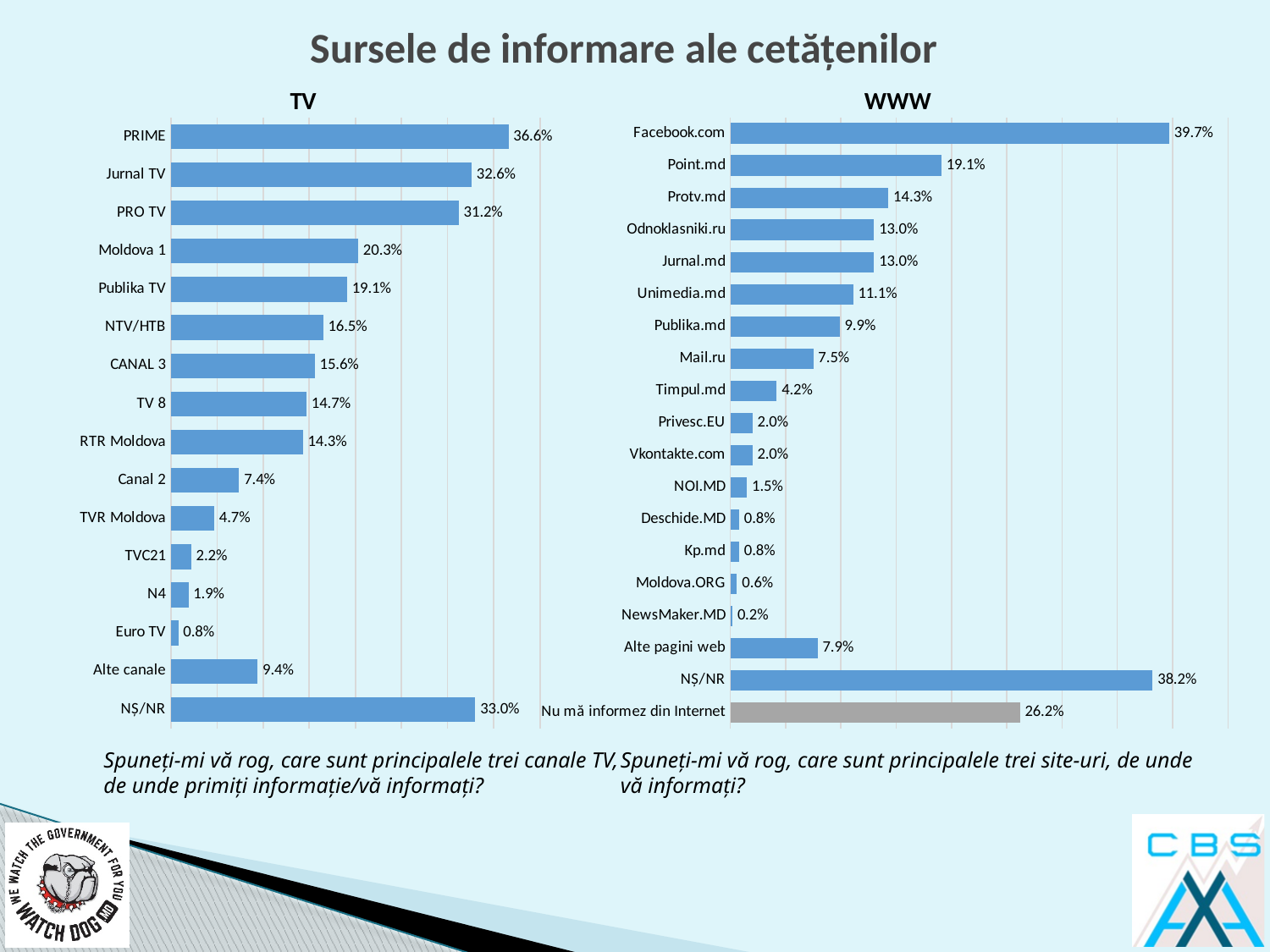
In the WWW chart, what is the value for Nu mă informez din Internet? 26.2% In the TV chart, what is the value for PRIME? 36.6% In the TV chart, what is the value for Moldova 1? 20.3% In the TV chart, what is the difference between Jurnal TV and PRO TV? 1.4% How many categories are shown in the TV chart? 16 How many categories are shown in the WWW chart? 19 In the TV chart, which is larger, Publika TV or NTV/HTB? Publika TV In the WWW chart, which site has the highest value? Facebook.com In the WWW chart, what is the value for Point.md? 19.1% In the WWW chart, what is the difference between Facebook.com and Point.md? 20.6% In the TV chart, which channel has the lowest value? Euro TV What type of chart is the WWW chart? Bar chart